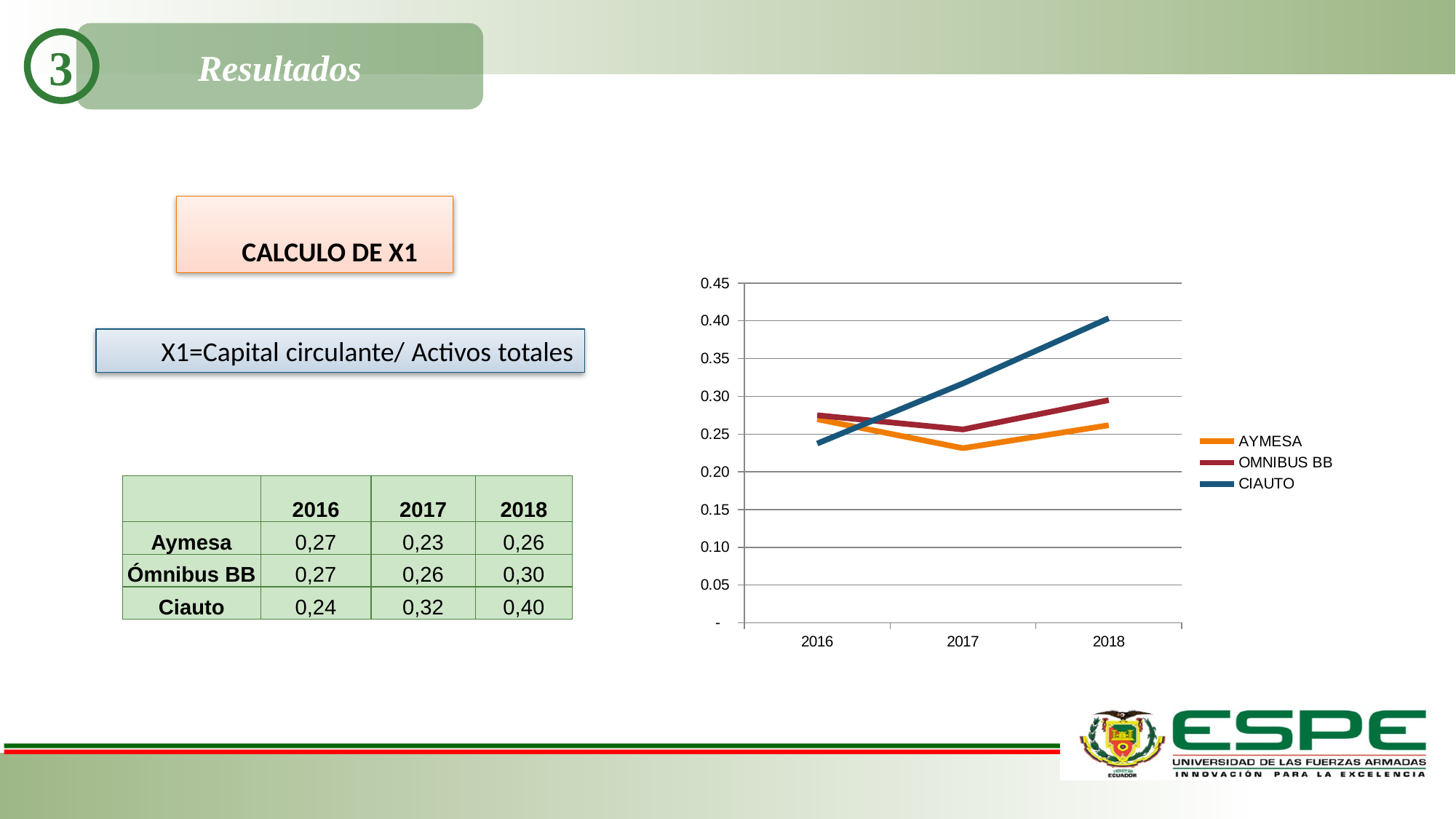
How many series does the chart legend list? 3 Using the table values, what is the difference between Ciauto's X1 in 2018 and in 2016? 0,16 According to the table on the slide, what is the X1 value for Ciauto in 2018? 0,40 Which series has the highest value in 2018? CIAUTO What kind of chart is shown on the slide? line chart Does the CIAUTO line rise or fall from 2016 to 2018? rise What colour is the CIAUTO line in the chart? blue In 2016, which is larger: the value for OMNIBUS BB or the value for CIAUTO? OMNIBUS BB Is the value for AYMESA in 2017 greater or less than 0.25? less Which series has the lowest value in 2017? AYMESA Is the value for CIAUTO in 2018 greater or less than 0.35? greater How many years are plotted along the x axis of the chart? 3